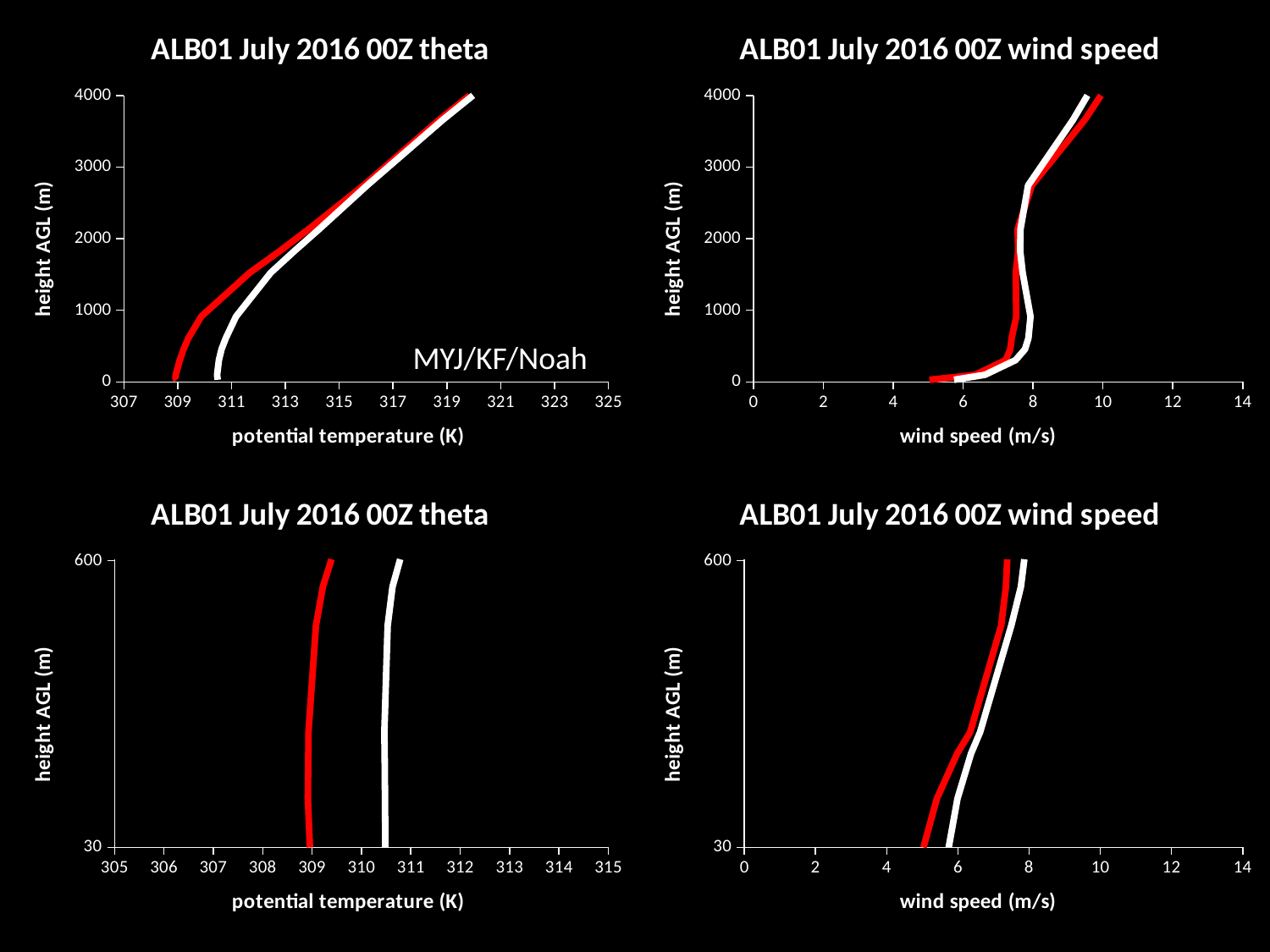
In the top-right chart (ALB01 July 2016 00Z wind speed), is the wind speed at 4000 m greater or less than 8 m/s? greater In the top-left chart (ALB01 July 2016 00Z theta), is the potential temperature at 4000 m greater or less than 317 K? greater In the bottom-left chart (ALB01 July 2016 00Z theta, 30–600 m), which line shows the higher potential temperature, the red or the white? white What text label is printed inside the top-left chart? MYJ/KF/Noah In the top-right chart (ALB01 July 2016 00Z wind speed), is the red line's wind speed at 0 m greater or less than 6 m/s? less What kind of chart is the top-left chart titled "ALB01 July 2016 00Z theta"? line chart In the top-left chart (ALB01 July 2016 00Z theta), at 1000 m, which line shows the higher potential temperature, the red or the white? white In the top-left chart (ALB01 July 2016 00Z theta), does potential temperature increase or decrease with height? increase How many charts are shown on the slide? 4